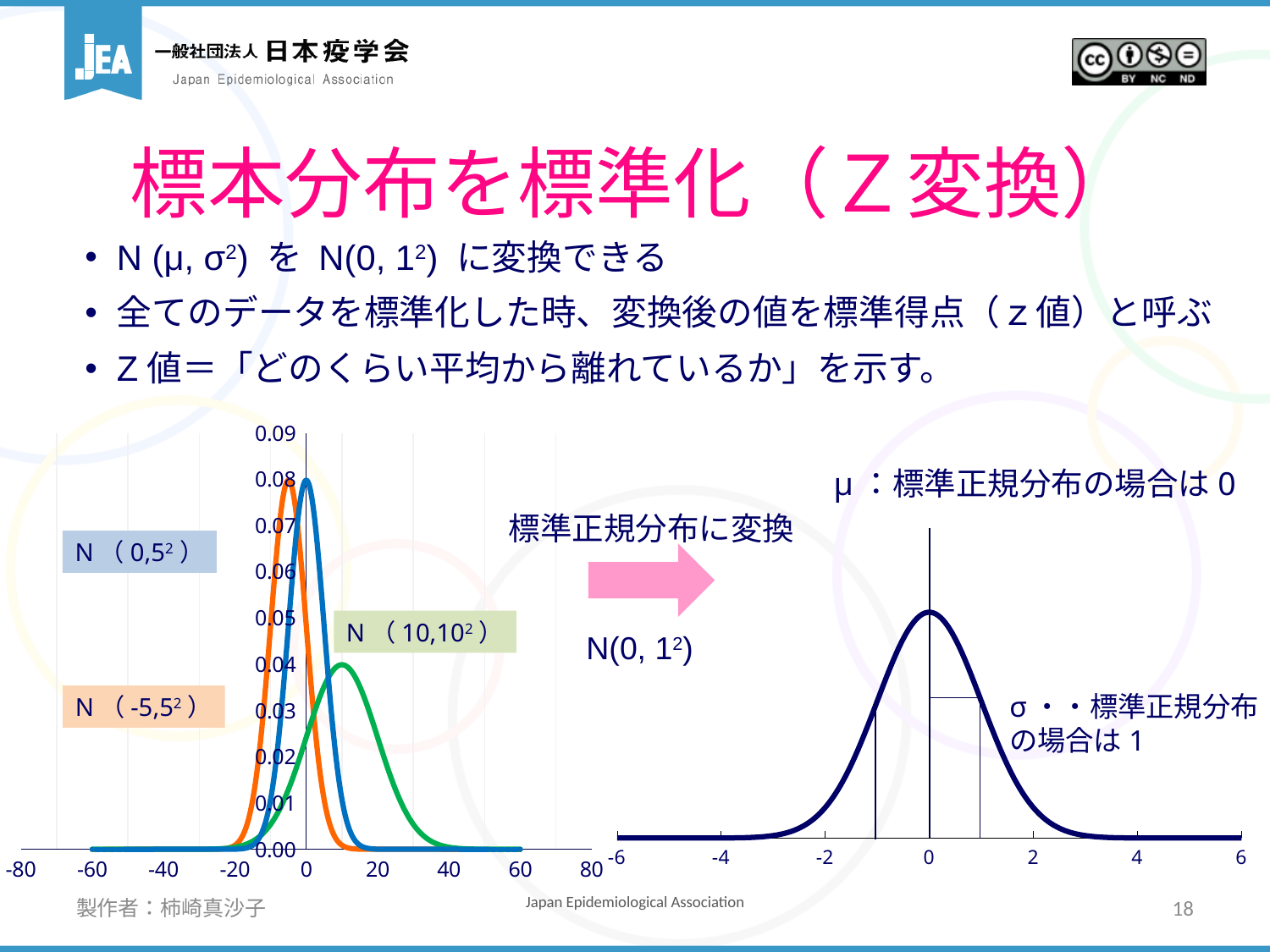
On the left chart, which distribution is drawn in orange? N(-5,5²) On the left chart, is the peak of the green N(10,10²) curve greater or less than 0.05? less On the left chart, what are the minimum and maximum values shown on the horizontal axis? -80 and 80 What kind of chart is the left chart showing the three distributions? line chart On the left chart, which curve has a higher peak, the green N(10,10²) curve or the blue N(0,5²) curve? N(0,5²) On the left chart, is the peak of the blue N(0,5²) curve greater or less than 0.07? greater On the right chart, does the curve rise or fall as x goes from 0 to 6? fall On the left chart, which distribution has the lowest peak? N(10,10²) On the right chart, at which x value does the standard normal curve reach its peak? 0 How many distribution curves are plotted on the left chart? 3 On the right chart, what are the minimum and maximum values shown on the horizontal axis? -6 and 6 On the left chart, what is the highest value shown on the vertical axis? 0.09